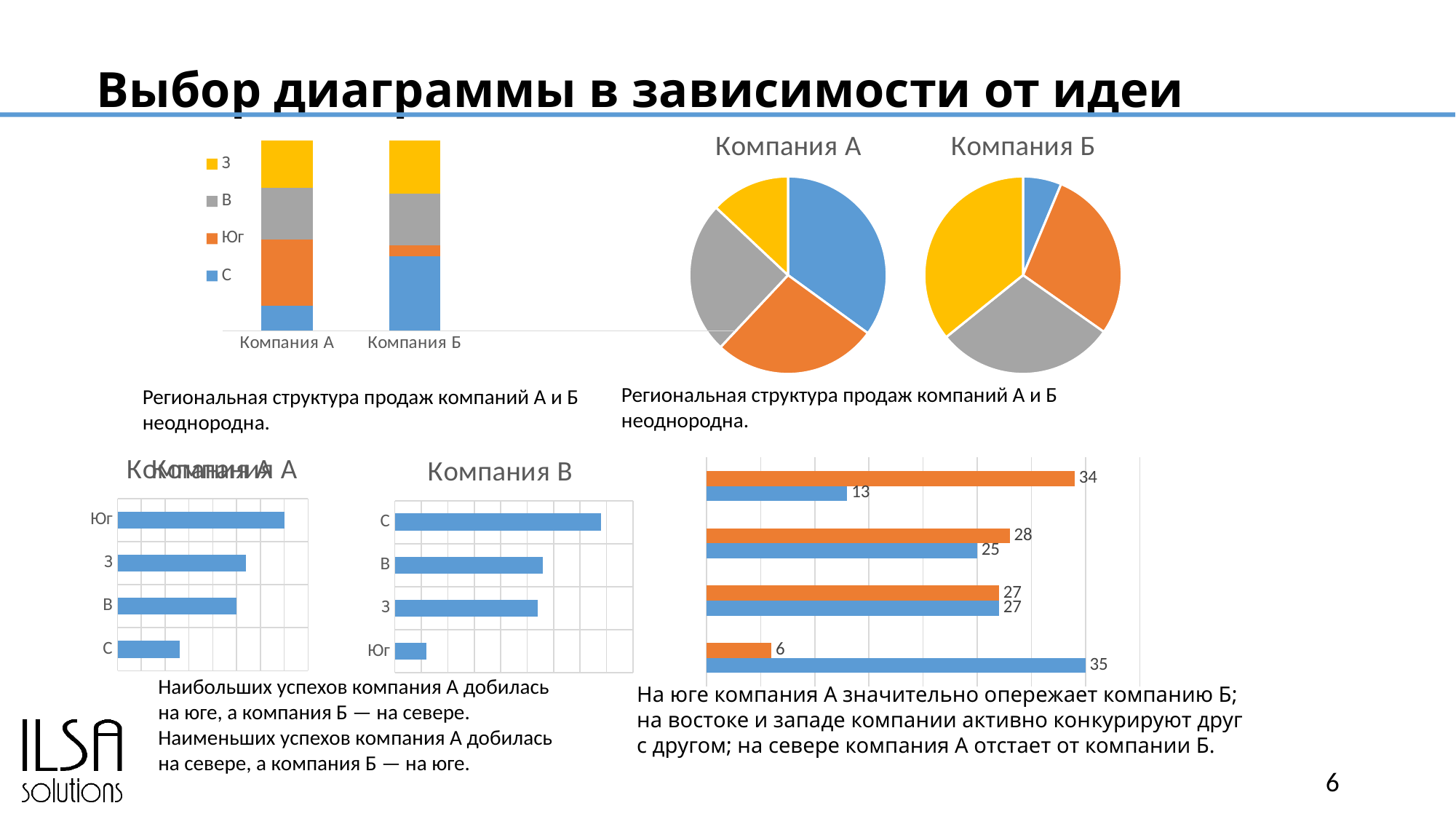
What kind of chart is the top-left chart with the categories Компания А and Компания Б? Stacked bar chart In the bottom-left bar chart titled Компания В, which category has the shortest bar? Юг In the bottom-right clustered bar chart, what is the largest value shown as a data label? 35 In the bottom-left bar chart titled Компания А, which category has the longest bar? Юг In the bottom-right clustered bar chart, what is the smallest value shown as a data label? 6 How many categories are shown on the x axis of the top-left stacked bar chart? 2 What are the legend entries of the top-left stacked bar chart, from top to bottom? З, В, Юг, С What kind of charts are the two charts titled Компания А and Компания Б in the top-right of the slide? Pie charts In the bottom-left bar chart titled Компания В, which category has the longest bar? С In the bottom-left bar chart titled Компания А, which category has the shortest bar? С How many series does the legend of the top-left stacked bar chart list? 4 In the bottom-right clustered bar chart, what is the difference between the orange bar (34) and the blue bar (13) in the topmost pair of bars? 21